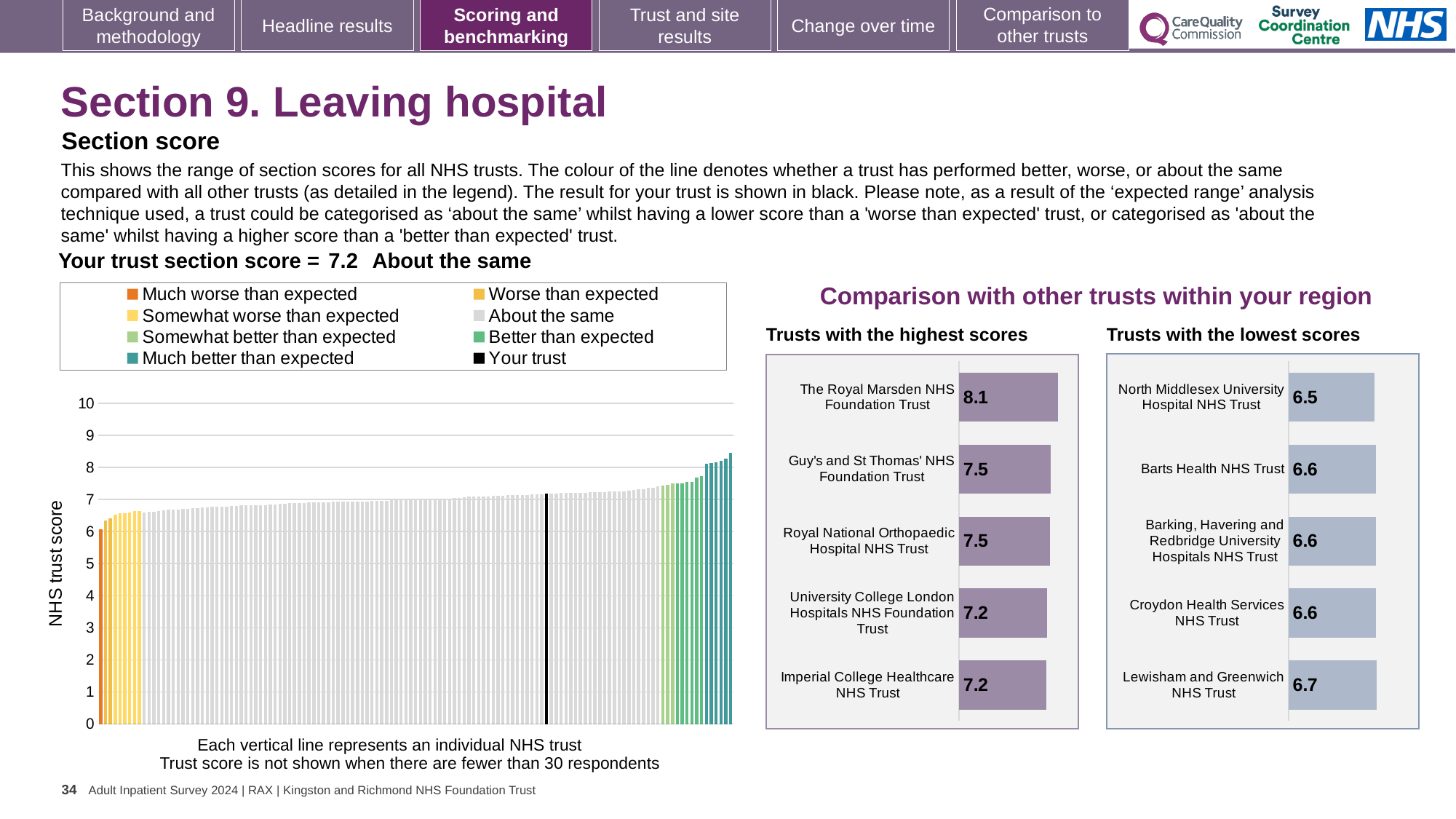
In the 'Trusts with the highest scores' chart, how many trusts are shown? 5 In the NHS trust score chart on the left, is the value of the leftmost (orange) bar greater or less than 7? less In the 'Trusts with the highest scores' chart, what is the score for The Royal Marsden NHS Foundation Trust? 8.1 In the 'Trusts with the lowest scores' chart, what is the score for Croydon Health Services NHS Trust? 6.6 How many entries does the legend of the NHS trust score chart on the left list? 8 In the NHS trust score chart on the left, what is the section score for your trust (the black line)? 7.2 In the 'Trusts with the lowest scores' chart, which has the larger score: Lewisham and Greenwich NHS Trust or North Middlesex University Hospital NHS Trust? Lewisham and Greenwich NHS Trust What kind of chart is the NHS trust score chart on the left? Bar chart In the 'Trusts with the lowest scores' chart, how many trusts are shown? 5 In the 'Trusts with the highest scores' chart, which trust has the highest score? The Royal Marsden NHS Foundation Trust In the 'Trusts with the lowest scores' chart, which trust has the lowest score? North Middlesex University Hospital NHS Trust In the 'Trusts with the highest scores' chart, what is the difference between the scores of The Royal Marsden NHS Foundation Trust and Imperial College Healthcare NHS Trust? 0.9